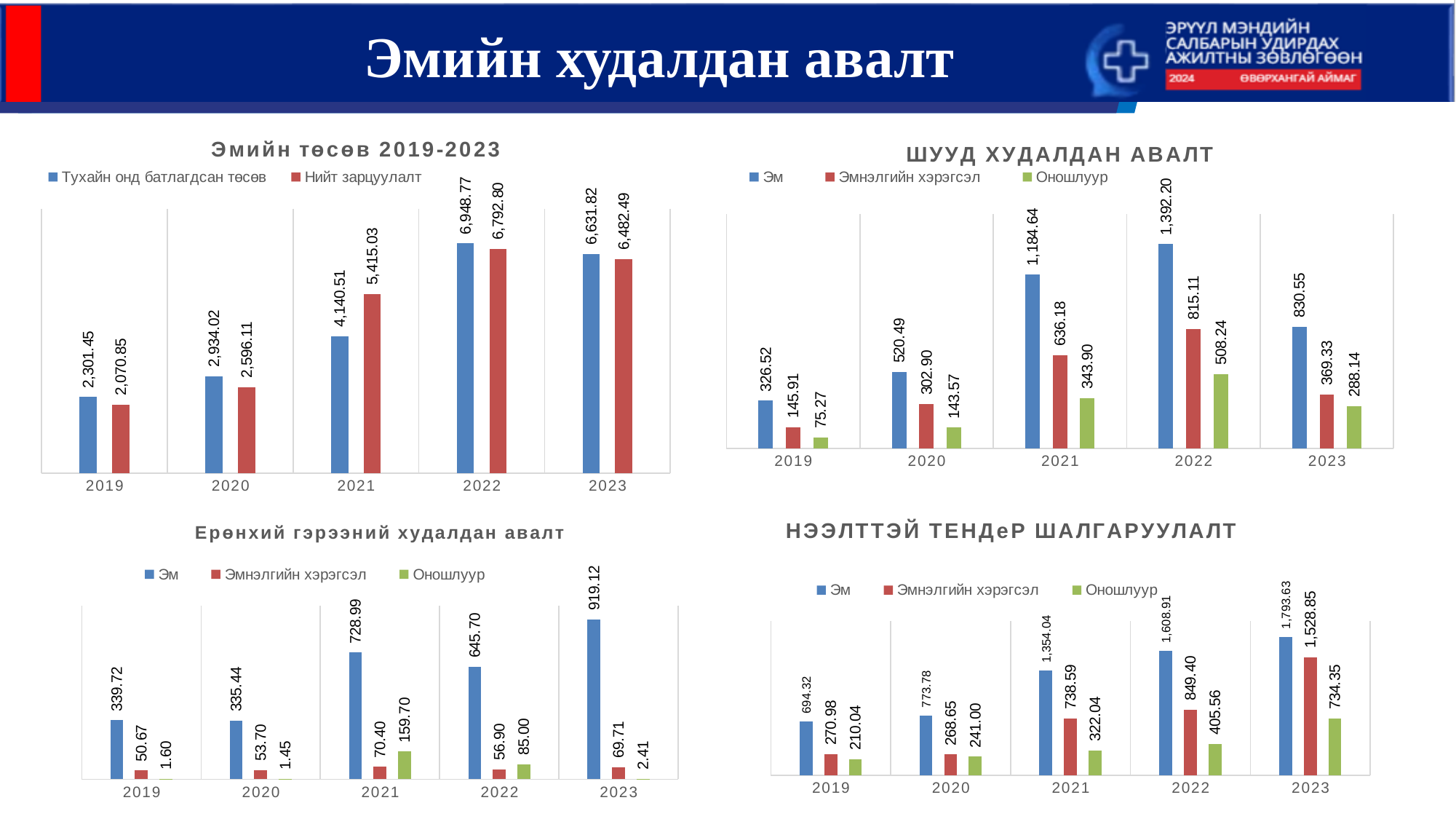
In the chart titled 'НЭЭЛТТЭЙ ТЕНДеР ШАЛГАРУУЛАЛТ', do the values for 'Эм' rise or fall from 2019 to 2023? rise In the chart titled 'Эмийн төсөв 2019-2023', what is the difference between 'Нийт зарцуулалт' and 'Тухайн онд батлагдсан төсөв' in 2021? 1,274.52 In the chart titled 'ШУУД ХУДАЛДАН АВАЛТ', how many series does the legend list? 3 In the chart titled 'ШУУД ХУДАЛДАН АВАЛТ', what is the value of 'Оношлуур' for 2022? 508.24 In the chart titled 'ШУУД ХУДАЛДАН АВАЛТ', which year has the highest value for 'Эм'? 2022 In the chart titled 'Эмийн төсөв 2019-2023', what is the value of 'Тухайн онд батлагдсан төсөв' for 2022? 6,948.77 In the chart titled 'Ерөнхий гэрээний худалдан авалт', how many years are shown on the x axis? 5 What kind of chart is the one titled 'НЭЭЛТТЭЙ ТЕНДеР ШАЛГАРУУЛАЛТ'? bar chart In the chart titled 'НЭЭЛТТЭЙ ТЕНДеР ШАЛГАРУУЛАЛТ', what is the value of 'Эмнэлгийн хэрэгсэл' for 2023? 1,528.85 In the chart titled 'Ерөнхий гэрээний худалдан авалт', which is larger in 2022: 'Эмнэлгийн хэрэгсэл' or 'Оношлуур'? Оношлуур In the chart titled 'Эмийн төсөв 2019-2023', which year has the lowest value for 'Нийт зарцуулалт'? 2019 In the chart titled 'Ерөнхий гэрээний худалдан авалт', what is the value of 'Оношлуур' for 2021? 159.70